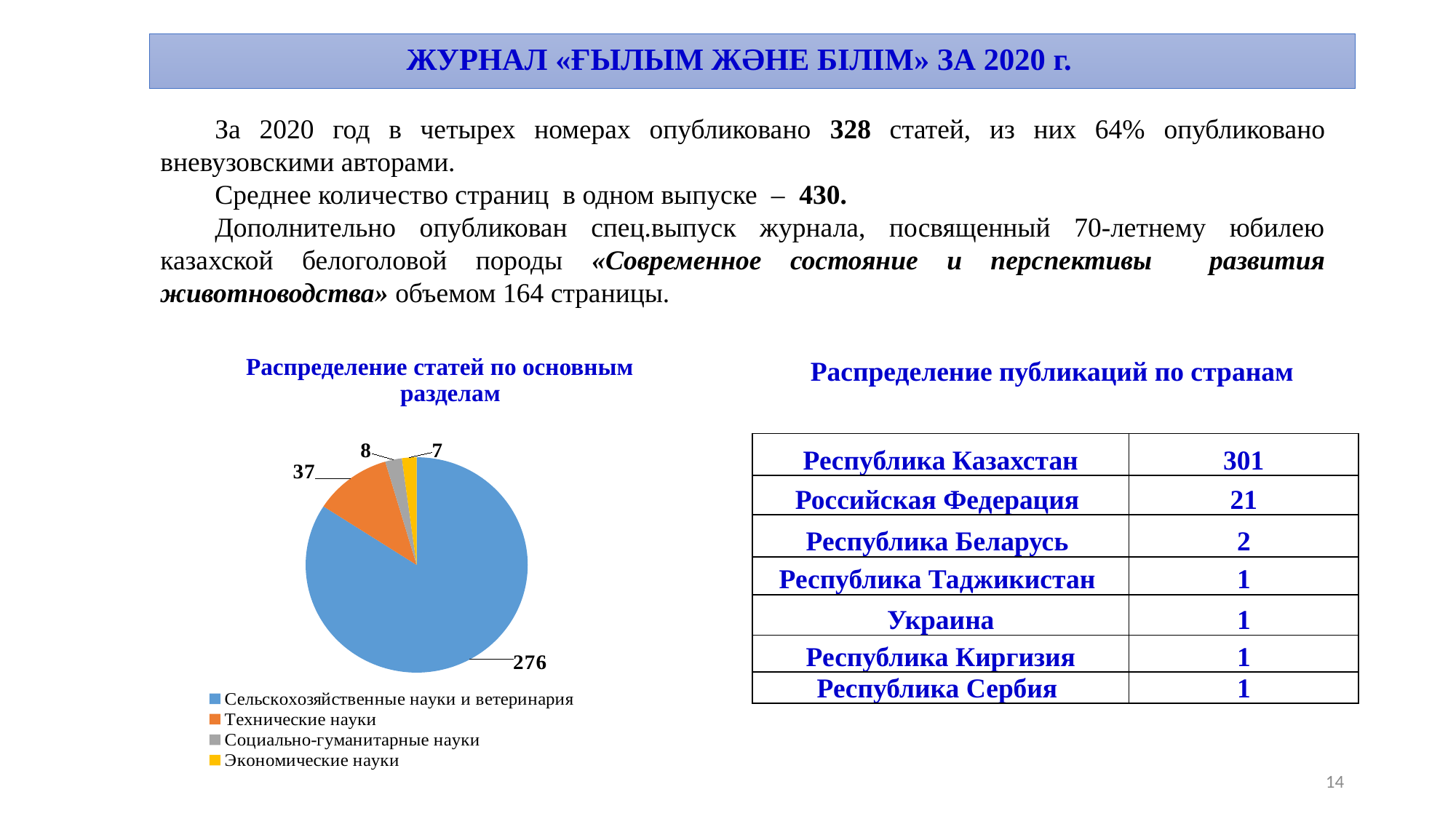
How many entries does the legend of the pie chart list? 4 How many slices does the pie chart have? 4 In the pie chart, what is the value for "Социально-гуманитарные науки"? 8 In the pie chart, which is larger: "Технические науки" or "Социально-гуманитарные науки"? Технические науки In the pie chart, what is the difference between the values for "Сельскохозяйственные науки и ветеринария" and "Технические науки"? 239 What kind of chart is shown under the title "Распределение статей по основным разделам"? pie chart In the pie chart, what is the value for "Экономические науки"? 7 In the pie chart, how many articles are in the "Сельскохозяйственные науки и ветеринария" section? 276 Which section has the largest slice in the pie chart? Сельскохозяйственные науки и ветеринария What colour is the "Технические науки" slice in the pie chart? orange In the pie chart, what is the value for "Технические науки"? 37 Which section has the smallest slice in the pie chart? Экономические науки